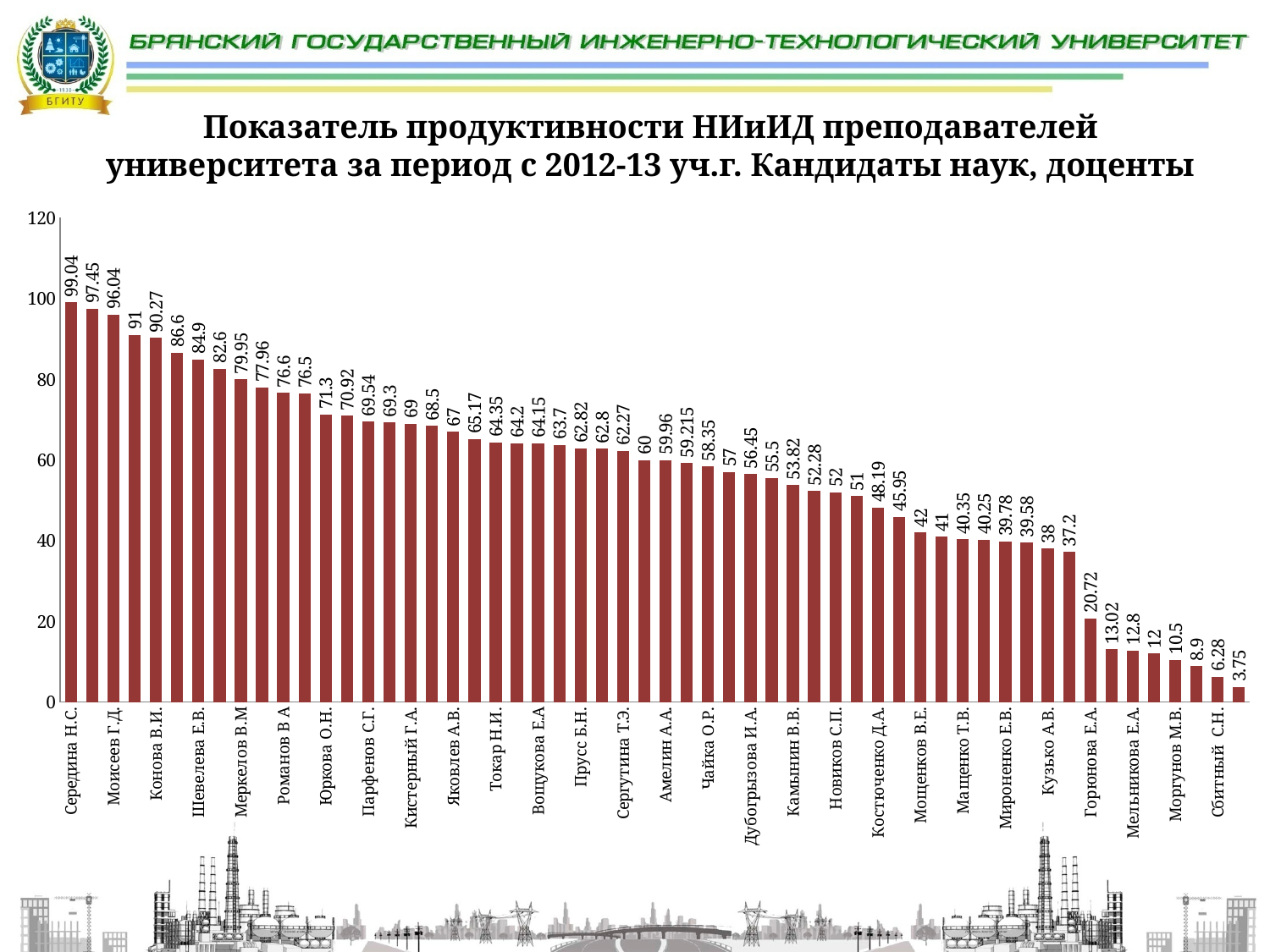
Is the value for Кузько А.В. greater or less than 40? less Do the values rise or fall from left to right along the x axis? fall What is the value for Середина Н.С.? 99.04 What is the value for Горюнова Е.А.? 20.72 Which labelled lecturer has the highest value? Середина Н.С. What is the value for Костюченко Д.А.? 48.19 What is the difference between the values for Горюнова Е.А. and Мельникова Е.А.? 7.92 What kind of chart is shown on the slide? bar chart What is the difference between the values for Середина Н.С. and Моисеев Г.Д.? 3 What is the value for Сбитный С.Н.? 6.28 What is the lowest value shown on the chart? 3.75 Which is larger, the value for Конова В.И. or for Шевелева Е.В.? Конова В.И.